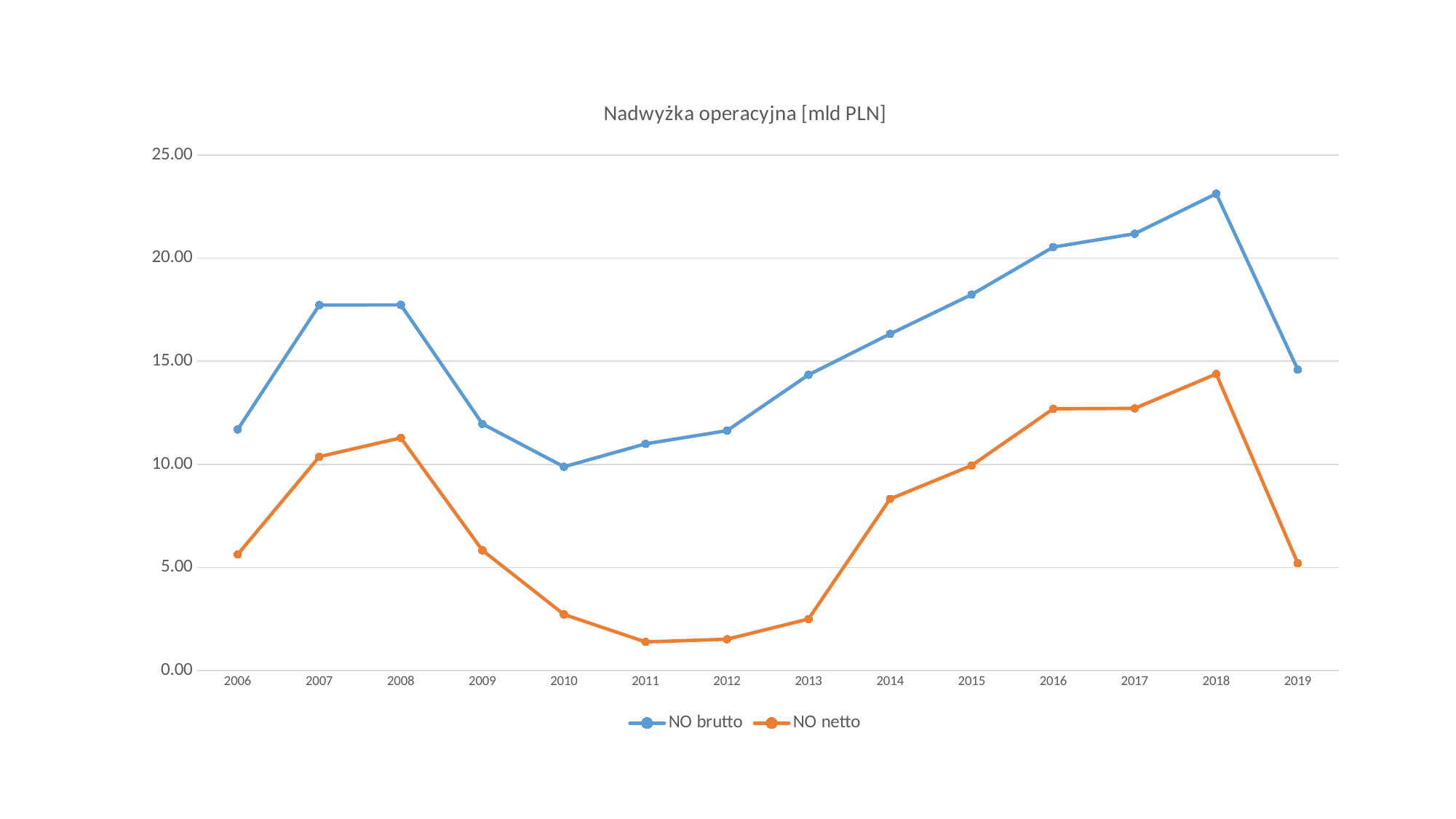
In which year does NO brutto reach its highest value? 2018 Is the value for NO netto in 2016 greater or less than 10.00? greater Is the value for NO netto in 2011 greater or less than 5.00? less How many series does the legend list? 2 What kind of chart is shown on the slide? line chart Does NO brutto rise or fall from 2013 to 2018? rise In which year does NO netto reach its highest value? 2018 What is the title of the chart? Nadwyżka operacyjna [mld PLN] Which is larger in 2019, NO brutto or NO netto? NO brutto How many years are plotted along the x axis? 14 In which year does NO brutto reach its lowest value? 2010 Is the value for NO brutto in 2018 greater or less than 20.00? greater